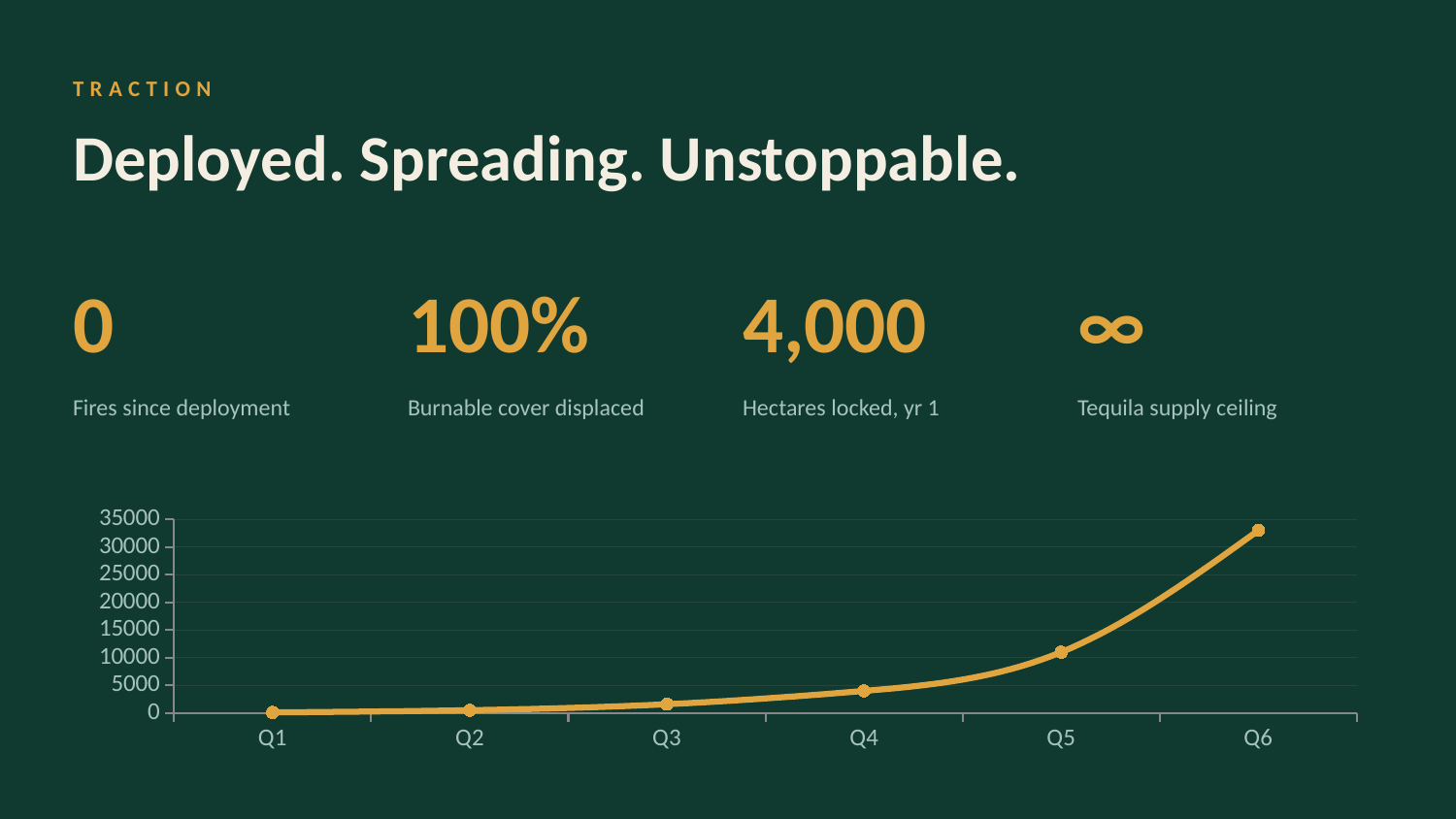
Is the value for Q6 on the line chart greater or less than 30000? greater Is the value for Q3 on the line chart greater or less than 5000? less Which is larger on the line chart, the value for Q4 or the value for Q5? Q5 Do the values on the line chart rise or fall from Q1 to Q6? rise Is the value for Q5 on the line chart greater or less than 5000? greater What is the label of the first category on the x axis of the line chart? Q1 Which quarter has the lowest value on the line chart? Q1 How many data points are plotted on the line chart? 6 What kind of chart is shown on the slide? line chart Which quarter has the highest value on the line chart? Q6 Which is larger on the line chart, the value for Q5 or the value for Q6? Q6 What is the highest value shown on the y axis of the line chart? 35000